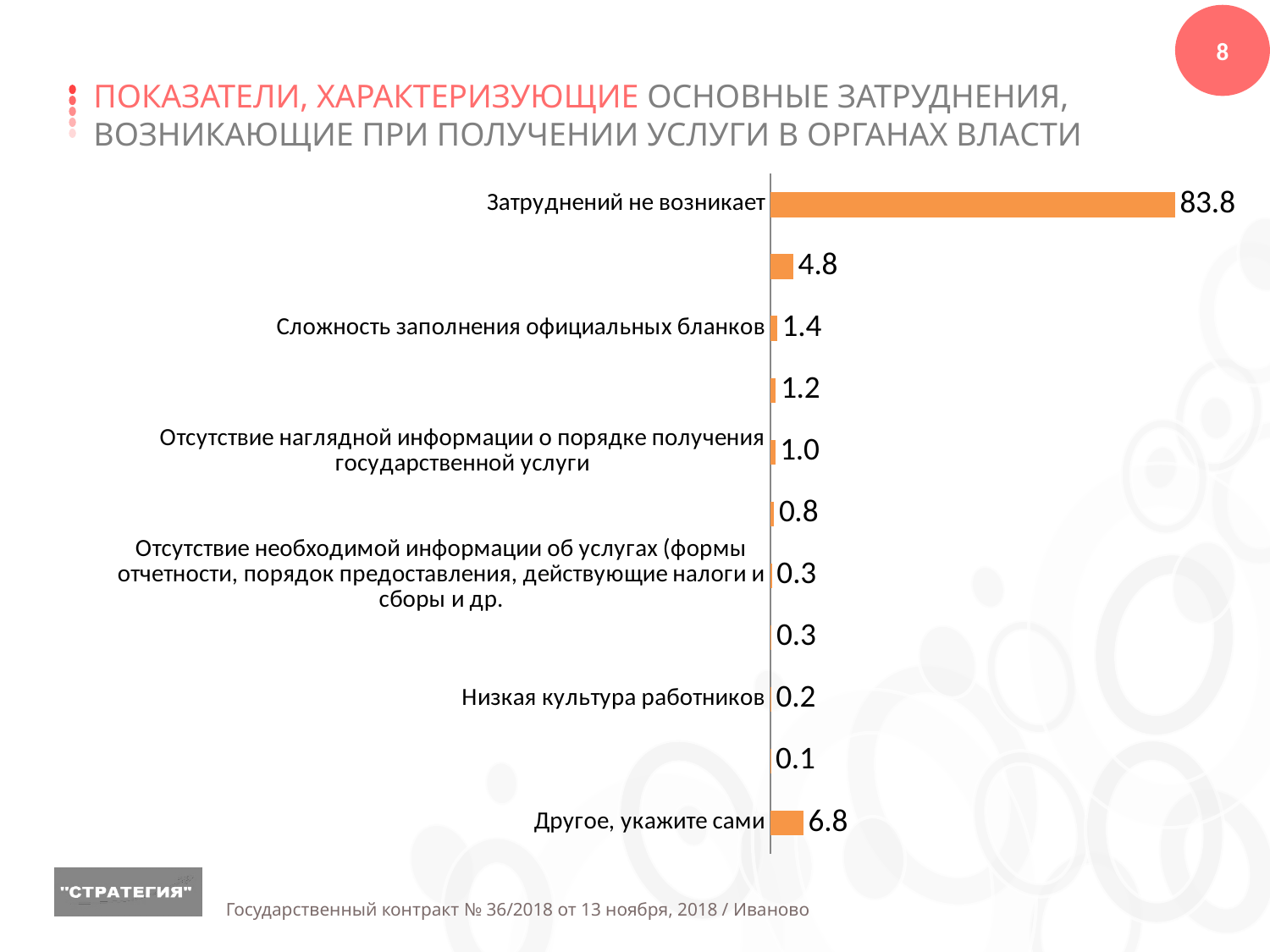
How many bars are plotted on the chart? 11 What is the difference between the values for "Затруднений не возникает" and "Другое, укажите сами"? 77.0 What value is shown for "Другое, укажите сами"? 6.8 What colour are the bars on the chart? Orange What value is shown for "Низкая культура работников"? 0.2 Which category has the highest value? Затруднений не возникает What value is shown for "Затруднений не возникает"? 83.8 What kind of chart is shown on the slide? Bar chart What value is shown for "Сложность заполнения официальных бланков"? 1.4 What value is shown for "Отсутствие наглядной информации о порядке получения государственной услуги"? 1.0 Which is larger: the value for "Другое, укажите сами" or for "Сложность заполнения официальных бланков"? Другое, укажите сами What is the smallest value shown on the chart? 0.1